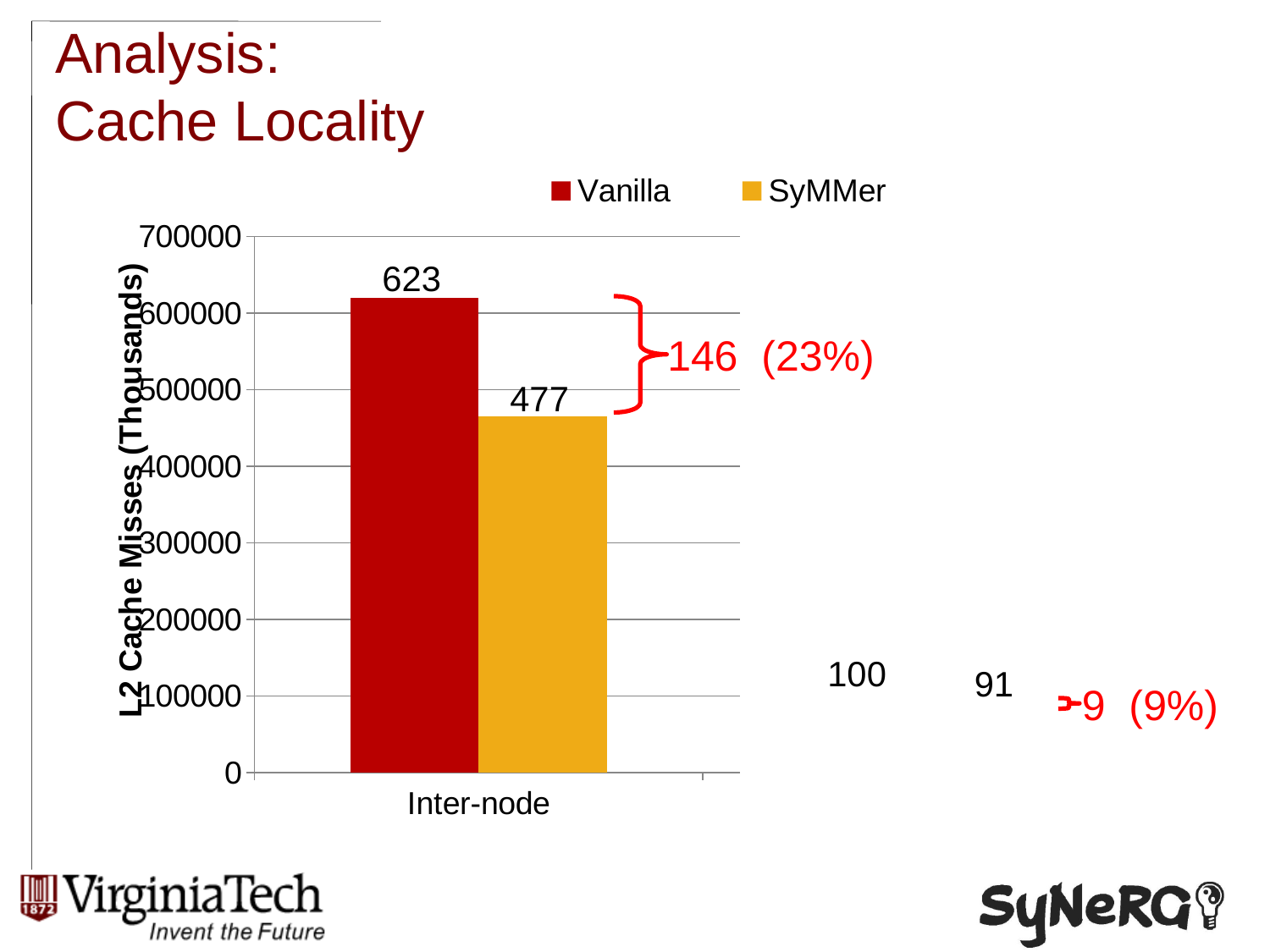
What is the difference between the Vanilla and SyMMer values for Inter-node? 146 How many series does the legend list? 2 Which series has the lower L2 cache misses for Inter-node? SyMMer What is the title of the y axis? L2 Cache Misses (Thousands) What kind of chart is shown on the slide? bar chart Is the Vanilla bar for Inter-node greater or less than 600000 on the y axis? greater What is the value of the Vanilla bar for Inter-node? 623 Is the Vanilla value or the SyMMer value larger for Inter-node? Vanilla Which series has the higher L2 cache misses for Inter-node? Vanilla What colour represents the Vanilla series? red What is the value of the SyMMer bar for Inter-node? 477 Is the SyMMer bar for Inter-node greater or less than 500000 on the y axis? less